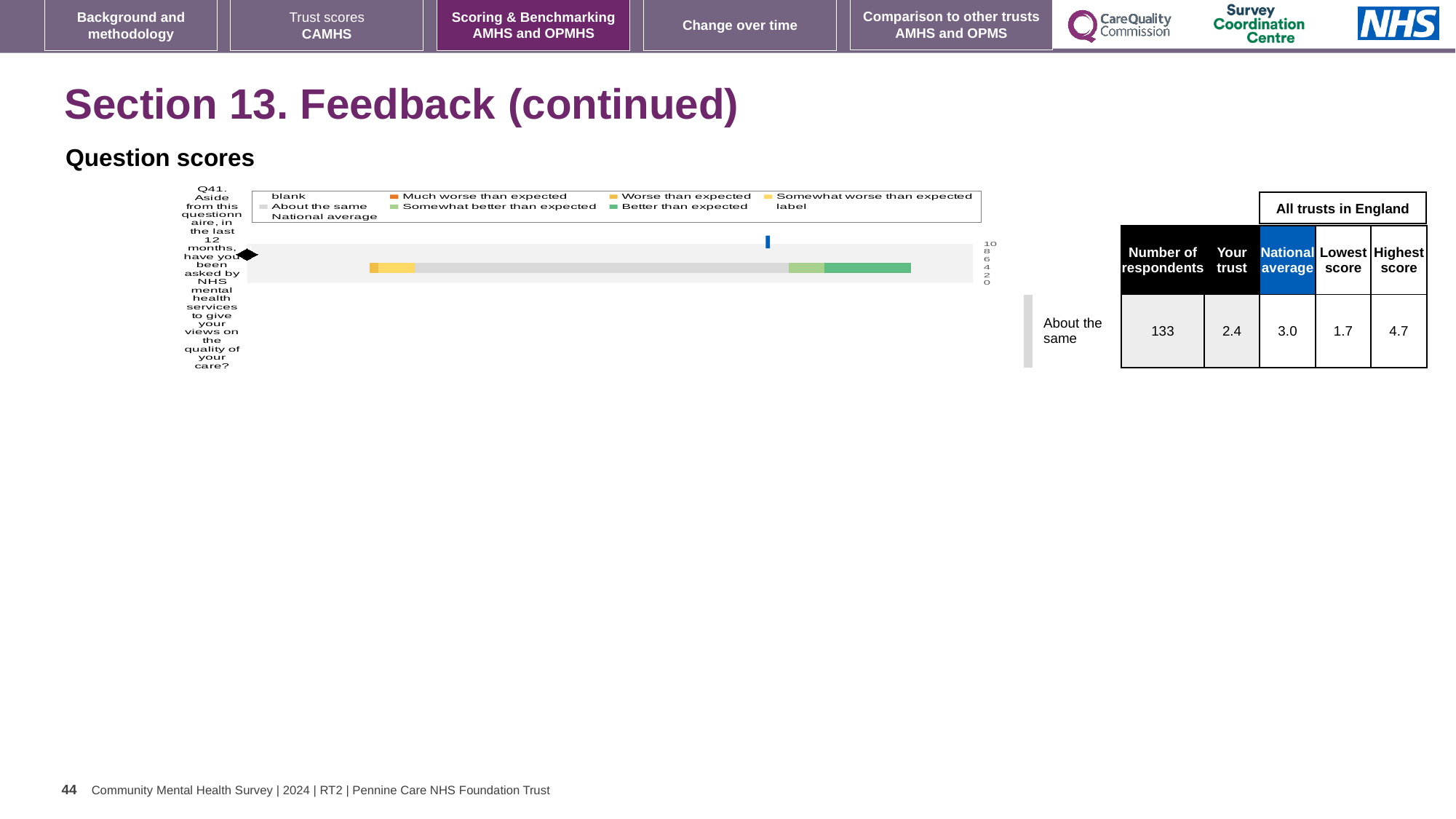
How many entries does the chart's legend list? 9 What kind of chart is shown on the slide for Q41? bar chart In the table beside the chart, what is the Highest score for Q41? 4.7 For Q41, what is the difference between the Highest score and the Lowest score? 3.0 In the table beside the chart, what is the 'Your trust' score for Q41? 2.4 For Q41, which is larger: the 'Your trust' score or the National average? National average In the table beside the chart, how many respondents answered Q41? 133 What colour is the 'About the same' segment in the chart's legend? grey How many questions (categories) are plotted in the chart? 1 In the table beside the chart, what is the National average score for Q41? 3.0 Which question number is plotted in the chart? Q41 In the table beside the chart, what is the Lowest score for Q41? 1.7